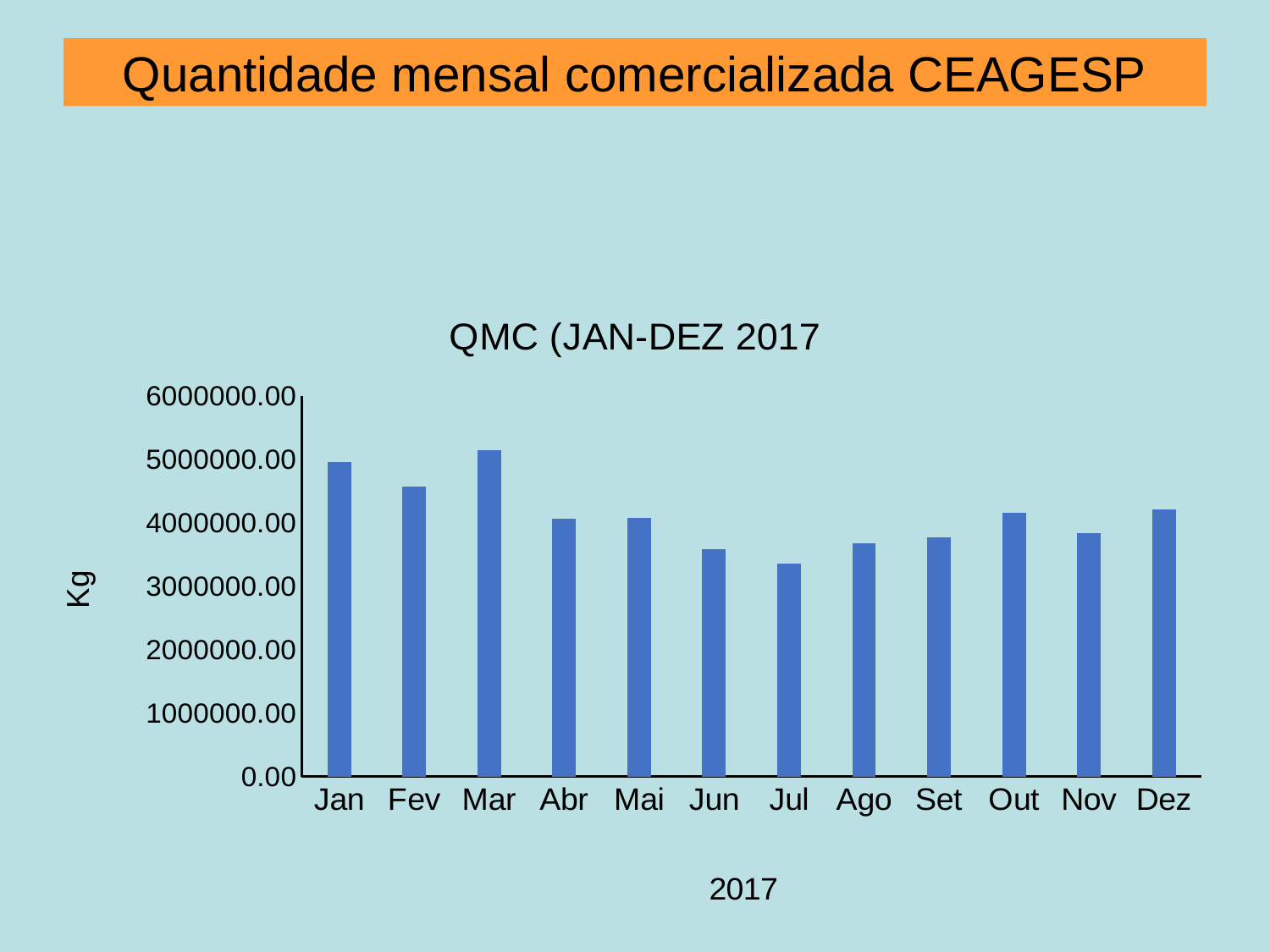
Is the value for Fev greater or less than 5000000.00? less Which month has the lowest quantity on the chart? Jul Is the value for Jan greater or less than 4000000.00? greater Which is larger, the value for Jan or the value for Dez? Jan What kind of chart is shown on the slide? bar chart What is the label on the vertical axis of the chart? Kg Is the value for Jul greater or less than 4000000.00? less What is the title of the chart? QMC (JAN-DEZ 2017 How many months (categories) are plotted on the chart? 12 Which is larger, the value for Fev or the value for Jun? Fev Which month has the highest quantity on the chart? Mar